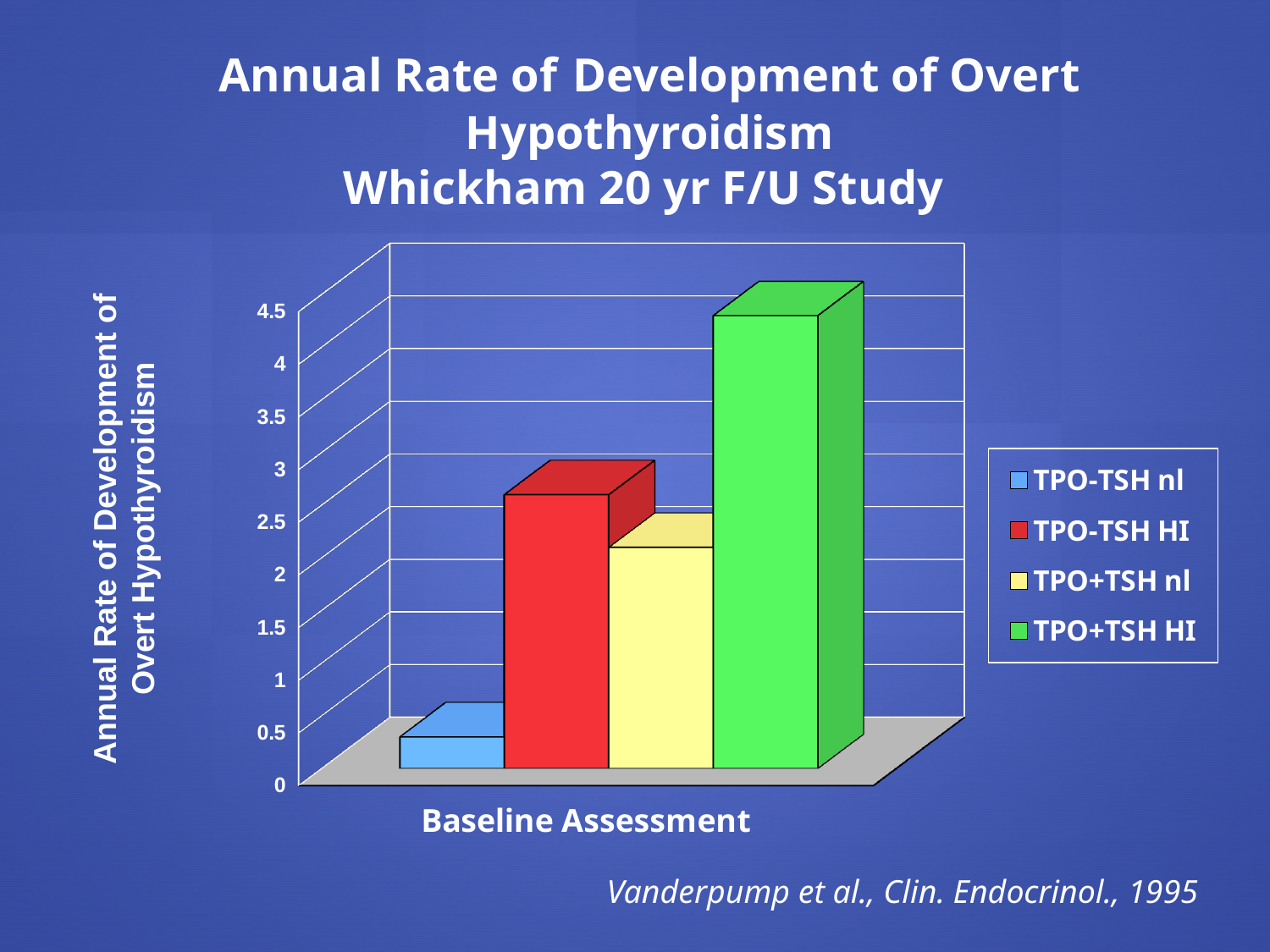
Which is larger, the value for TPO-TSH HI or the value for TPO+TSH nl? TPO-TSH HI What is the label on the x axis of the chart? Baseline Assessment Which is larger, the value for TPO+TSH HI or the value for TPO-TSH HI? TPO+TSH HI Is the value for TPO+TSH nl greater or less than 2.5? less Is the value for TPO-TSH nl greater or less than 0.5? less Is the value for TPO-TSH HI greater or less than 2? greater Which series has the highest annual rate of development of overt hypothyroidism? TPO+TSH HI What colour is the bar for TPO+TSH nl? yellow What kind of chart is shown on the slide? bar chart How many series does the legend list? 4 Which series has the lowest annual rate of development of overt hypothyroidism? TPO-TSH nl